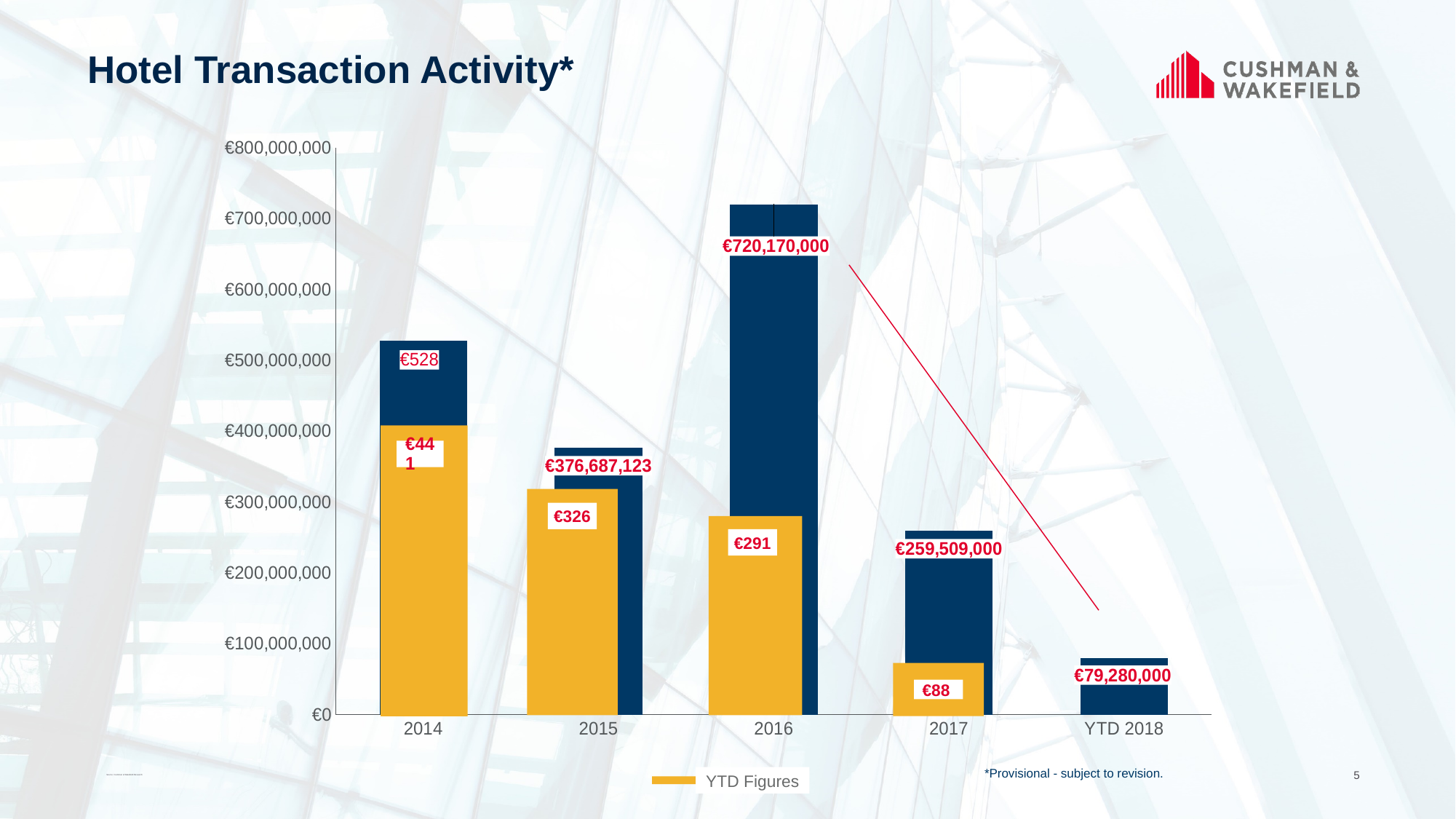
Which period has the lowest hotel transaction value? YTD 2018 Which year has the highest hotel transaction value? 2016 What is the hotel transaction value shown for YTD 2018? €79,280,000 What is the hotel transaction value shown for 2017? €259,509,000 How many periods are shown on the x axis? 5 What is the YTD Figures value labelled on the yellow bar for 2017? €88 What is the difference between the 2016 and 2017 hotel transaction values? €460,661,000 What is the hotel transaction value shown for 2015? €376,687,123 Is the hotel transaction value for 2014 greater or less than €500,000,000? greater What type of chart is shown on the slide? bar chart Do the hotel transaction values rise or fall from 2016 to YTD 2018? fall What is the hotel transaction value shown for 2016? €720,170,000